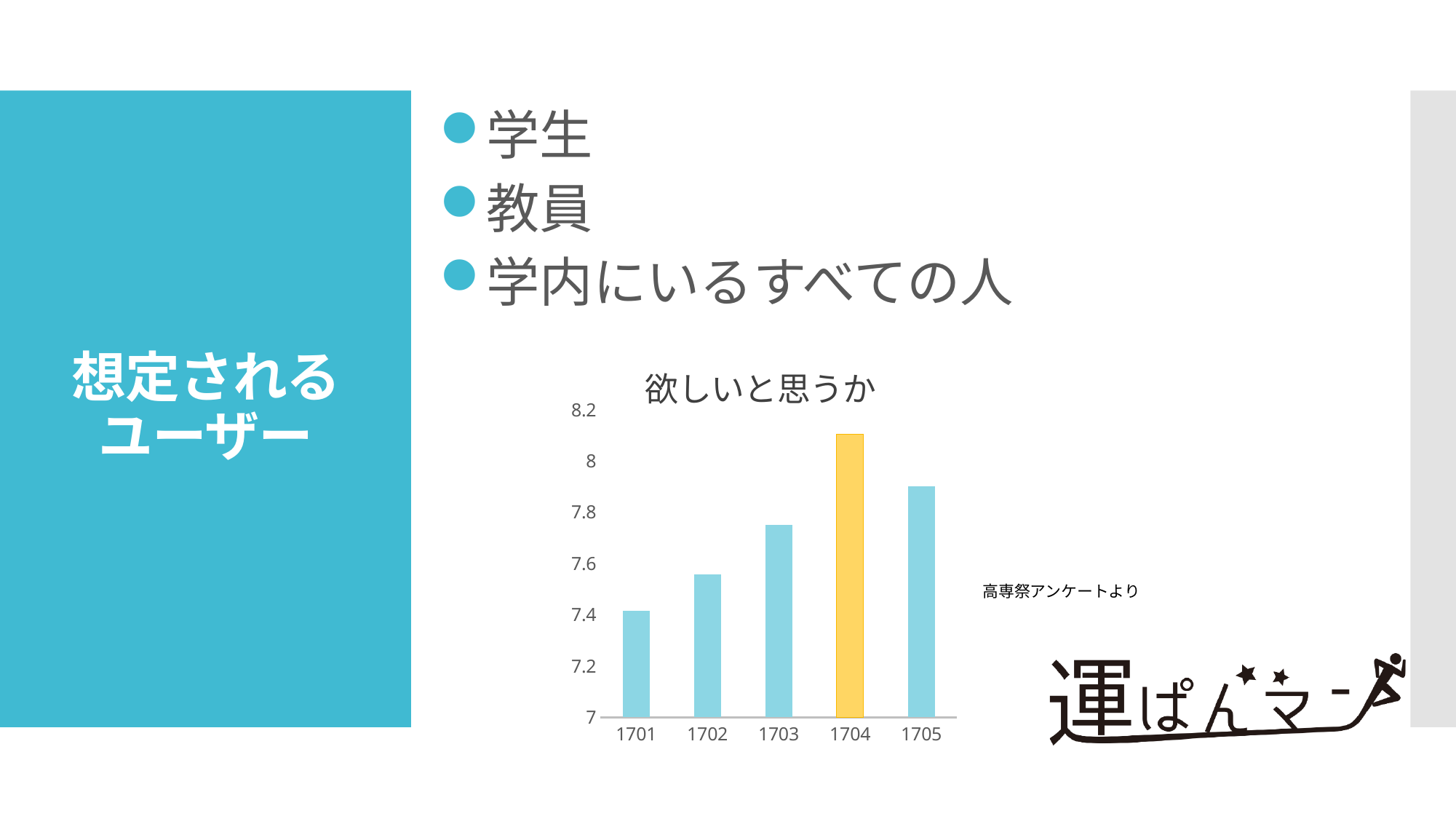
Is the value for 1703 greater or less than 7.6? greater Do the values rise or fall from 1701 to 1704? rise Which has the larger value, 1702 or 1703? 1703 How many categories are shown on the x axis of the chart? 5 Which category has the highest bar in the chart? 1704 Which has the larger value, 1704 or 1705? 1704 What is the title of the chart? 欲しいと思うか Is the value for 1705 greater or less than 8? less Which category has the lowest bar in the chart? 1701 Is the value for 1701 greater or less than 7.6? less What kind of chart is shown on the slide? bar chart